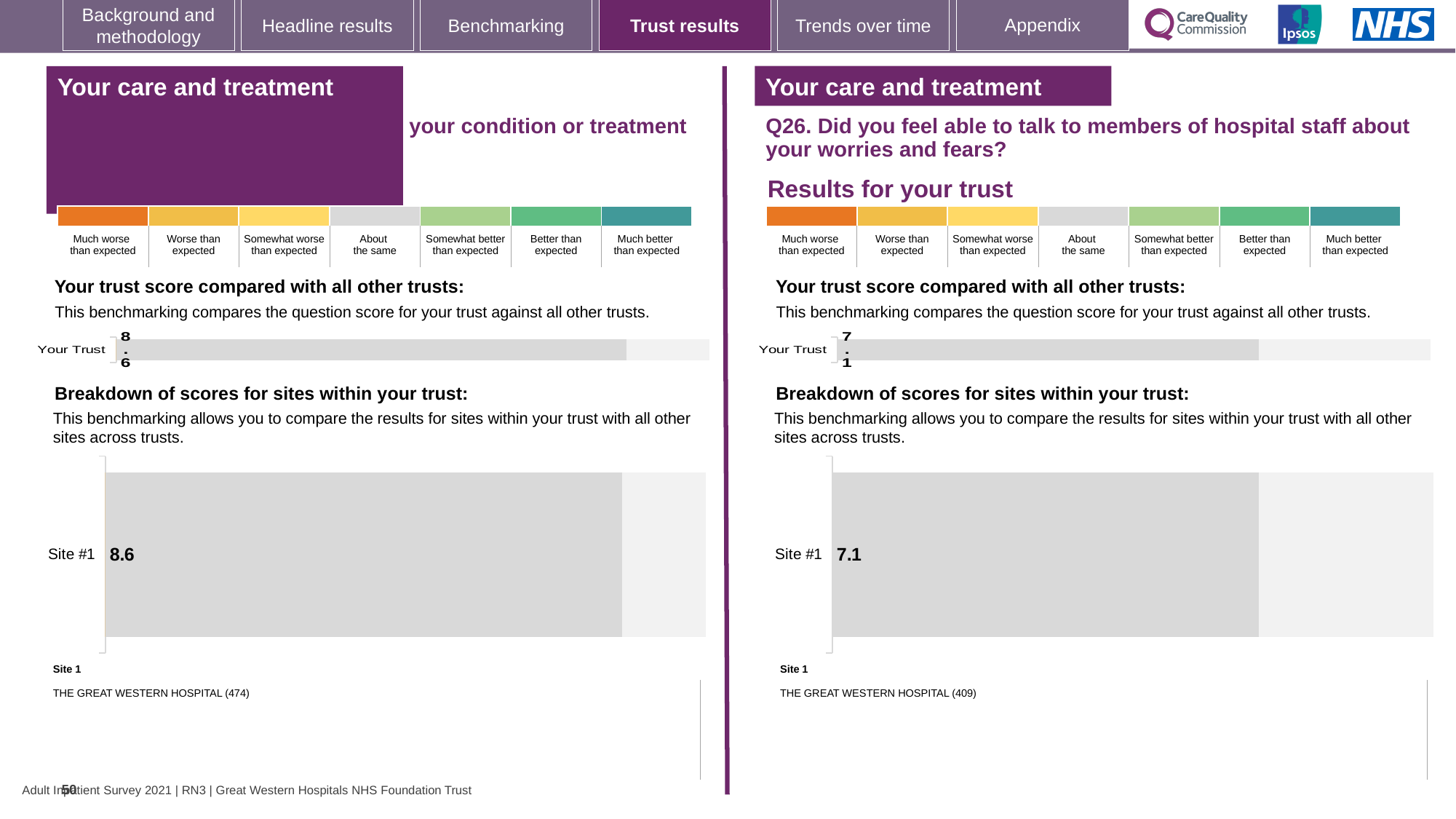
What is the difference between the Your Trust score in the left panel and the Your Trust score in the right panel (Q26)? 1.5 How many sites are shown in the 'Breakdown of scores for sites within your trust' chart in the right panel (Q26)? 1 What type of chart is used to show the Site #1 score in the right panel (Q26)? Bar chart Which panel shows the higher Site #1 score, the left panel or the right panel (Q26)? Left panel In the right panel (Q26), what is the score shown for Your Trust in the 'Your trust score compared with all other trusts' chart? 7.1 Which panel shows the higher Your Trust score, the left panel or the right panel (Q26)? Left panel In the right panel (Q26), what score is shown for Site #1 in the 'Breakdown of scores for sites within your trust' chart? 7.1 In the left panel, what is the score shown for Your Trust in the 'Your trust score compared with all other trusts' chart? 8.6 What is the difference between the Site #1 score in the left panel and the Site #1 score in the right panel (Q26)? 1.5 In the left panel, what score is shown for Site #1 in the 'Breakdown of scores for sites within your trust' chart? 8.6 In the left panel, what number appears in parentheses after THE GREAT WESTERN HOSPITAL under Site 1? 474 In the right panel (Q26), which hospital is listed as Site 1 below the breakdown chart? THE GREAT WESTERN HOSPITAL (409)